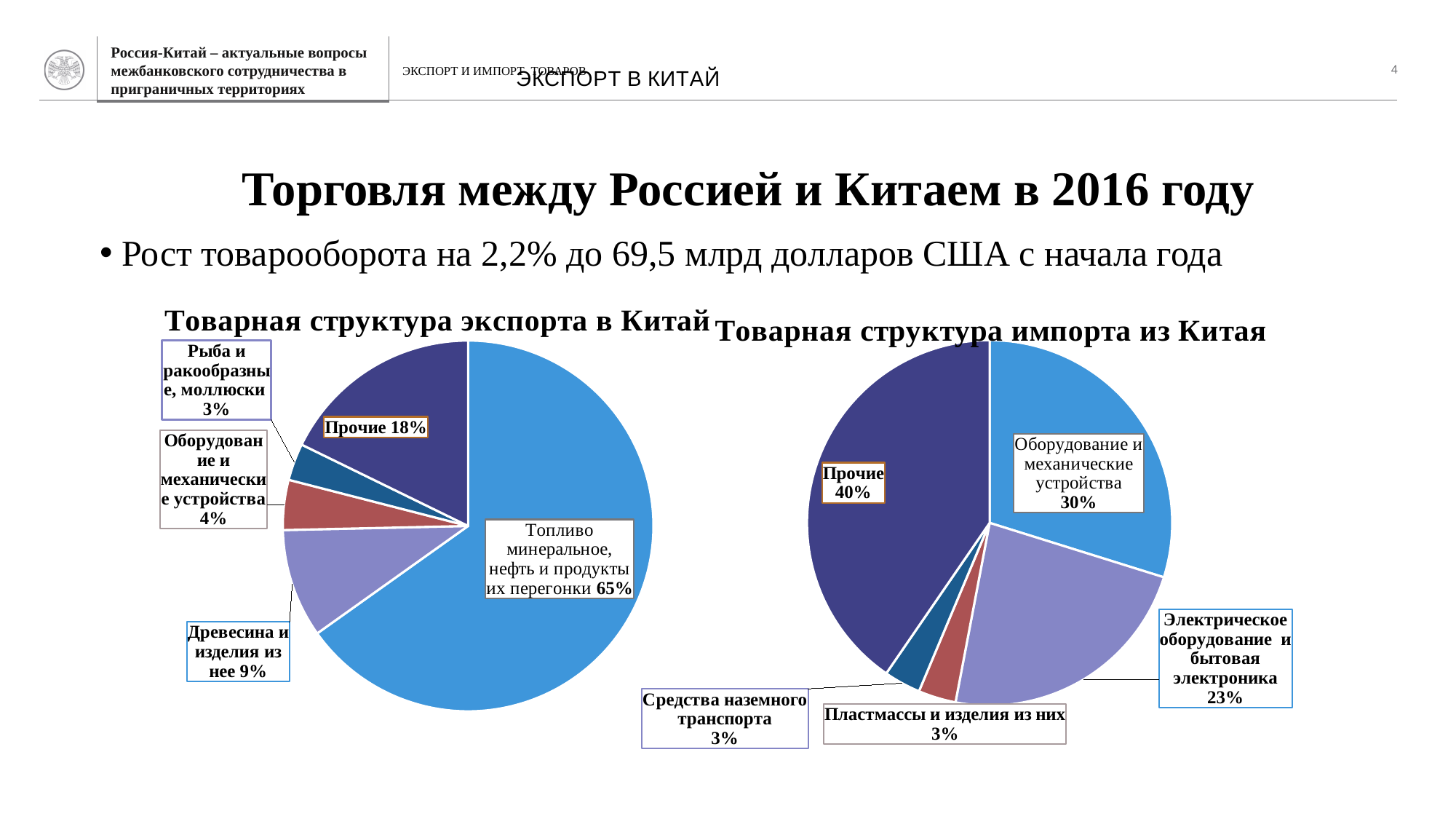
In the chart 'Товарная структура импорта из Китая', what is the difference between 'Прочие' and 'Оборудование и механические устройства'? 10% In the chart 'Товарная структура экспорта в Китай', how many slices are there? 5 In the chart 'Товарная структура импорта из Китая', what share does 'Электрическое оборудование и бытовая электроника' have? 23% How many pie charts are shown on the slide? 2 In the chart 'Товарная структура импорта из Китая', which is larger: 'Оборудование и механические устройства' or 'Электрическое оборудование и бытовая электроника'? Оборудование и механические устройства In the chart 'Товарная структура экспорта в Китай', which category has the smallest share? Рыба и ракообразные, моллюски In the chart 'Товарная структура импорта из Китая', what is the value for 'Оборудование и механические устройства'? 30% In the chart 'Товарная структура импорта из Китая', which category has the largest share? Прочие In the chart 'Товарная структура экспорта в Китай', what share does 'Топливо минеральное, нефть и продукты их перегонки' have? 65% What type of chart is 'Товарная структура экспорта в Китай'? pie chart In the chart 'Товарная структура экспорта в Китай', what is the value for 'Древесина и изделия из нее'? 9% In the chart 'Товарная структура экспорта в Китай', what is the difference between 'Прочие' and 'Древесина и изделия из нее'? 9%